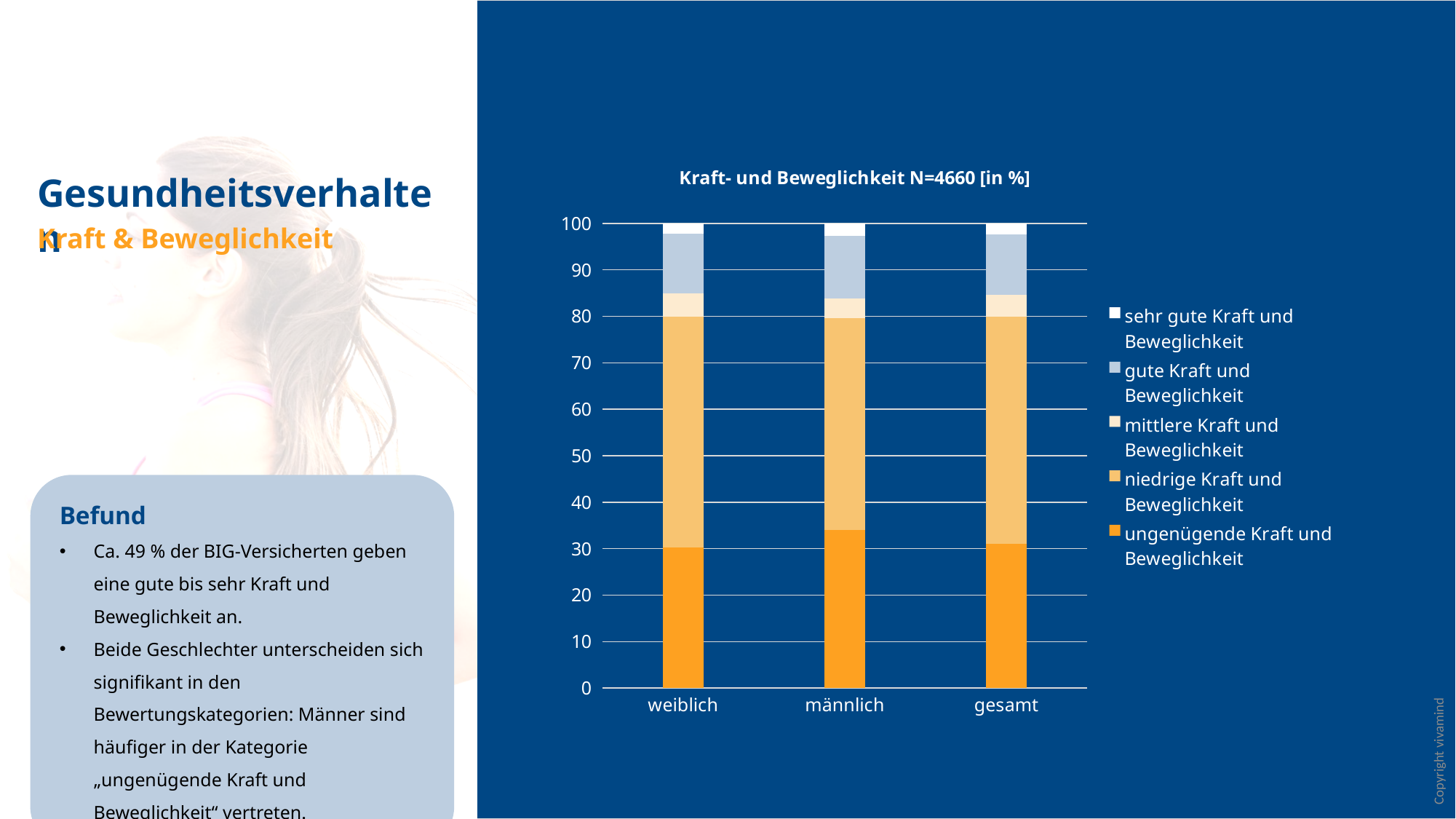
What is the sample size N given in the chart title? 4660 In the gesamt bar, does the top of the 'gute Kraft und Beweglichkeit' segment lie above or below 90? above Is the 'ungenügende Kraft und Beweglichkeit' segment larger for männlich or for weiblich? männlich Which category has the largest segment for 'ungenügende Kraft und Beweglichkeit'? männlich What is the title of the chart? Kraft- und Beweglichkeit N=4660 [in %] How many series does the chart legend list? 5 Is the value for 'ungenügende Kraft und Beweglichkeit' in the männlich bar greater or less than 30? greater What kind of chart is shown on the slide? stacked bar chart How many categories are shown on the x axis of the chart? 3 In the weiblich bar, does the top of the 'mittlere Kraft und Beweglichkeit' segment lie above or below 80? above Which series is shown in the darkest orange colour at the bottom of each bar? ungenügende Kraft und Beweglichkeit